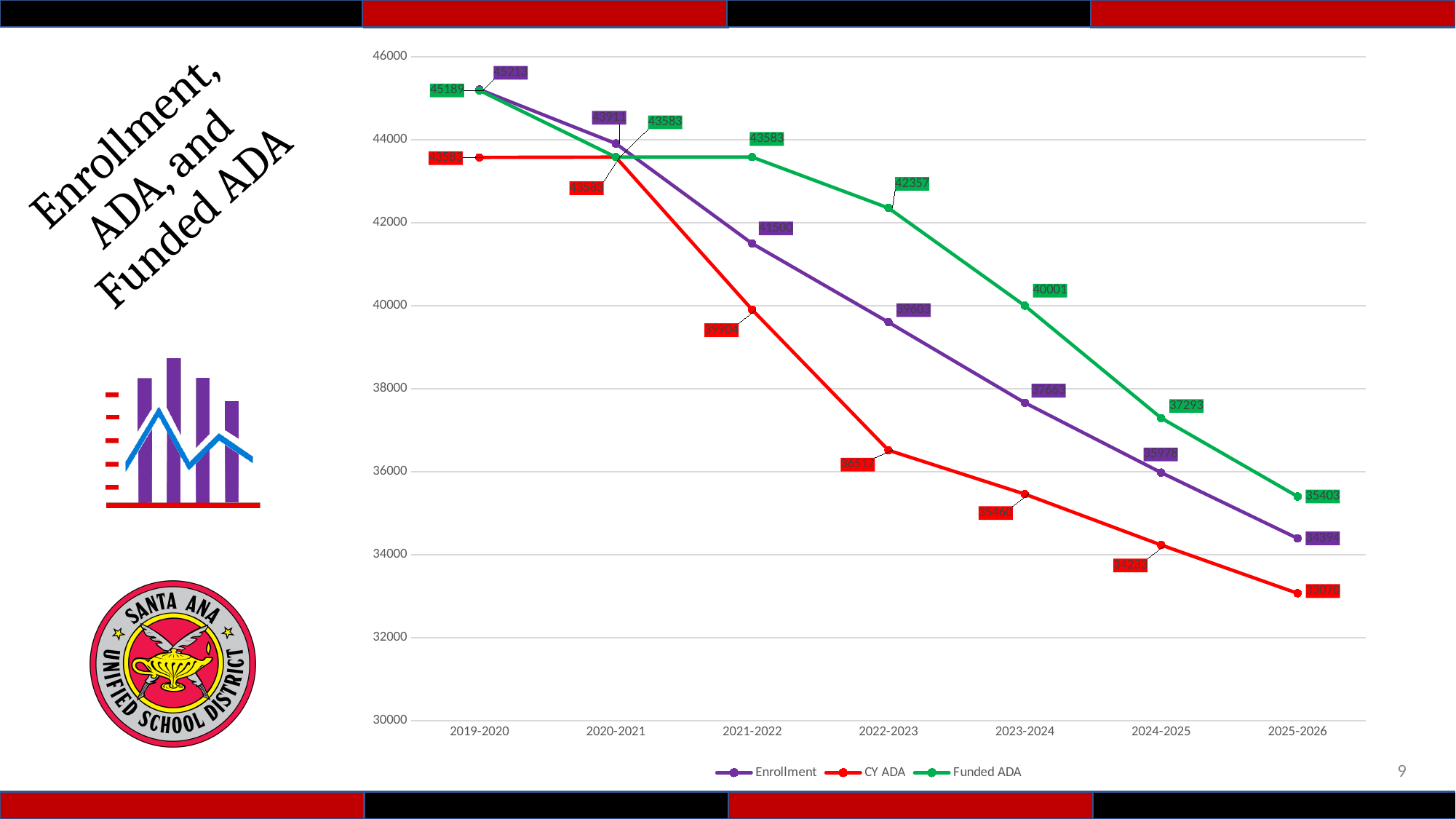
Does Enrollment rise or fall from 2019-2020 to 2025-2026? Fall How many series does the legend list? 3 What is the Enrollment value for 2019-2020? 45213 What kind of chart is shown on the slide? Line chart In which school year is Funded ADA highest? 2019-2020 How many school years are shown on the x axis? 7 In which school year is Enrollment lowest? 2025-2026 In 2021-2022, which is larger: Funded ADA or Enrollment? Funded ADA What is the Funded ADA value for 2023-2024? 40001 What is the CY ADA value for 2022-2023? 36517 What is the difference between Funded ADA and CY ADA in 2025-2026? 2333 Which series is drawn in red? CY ADA